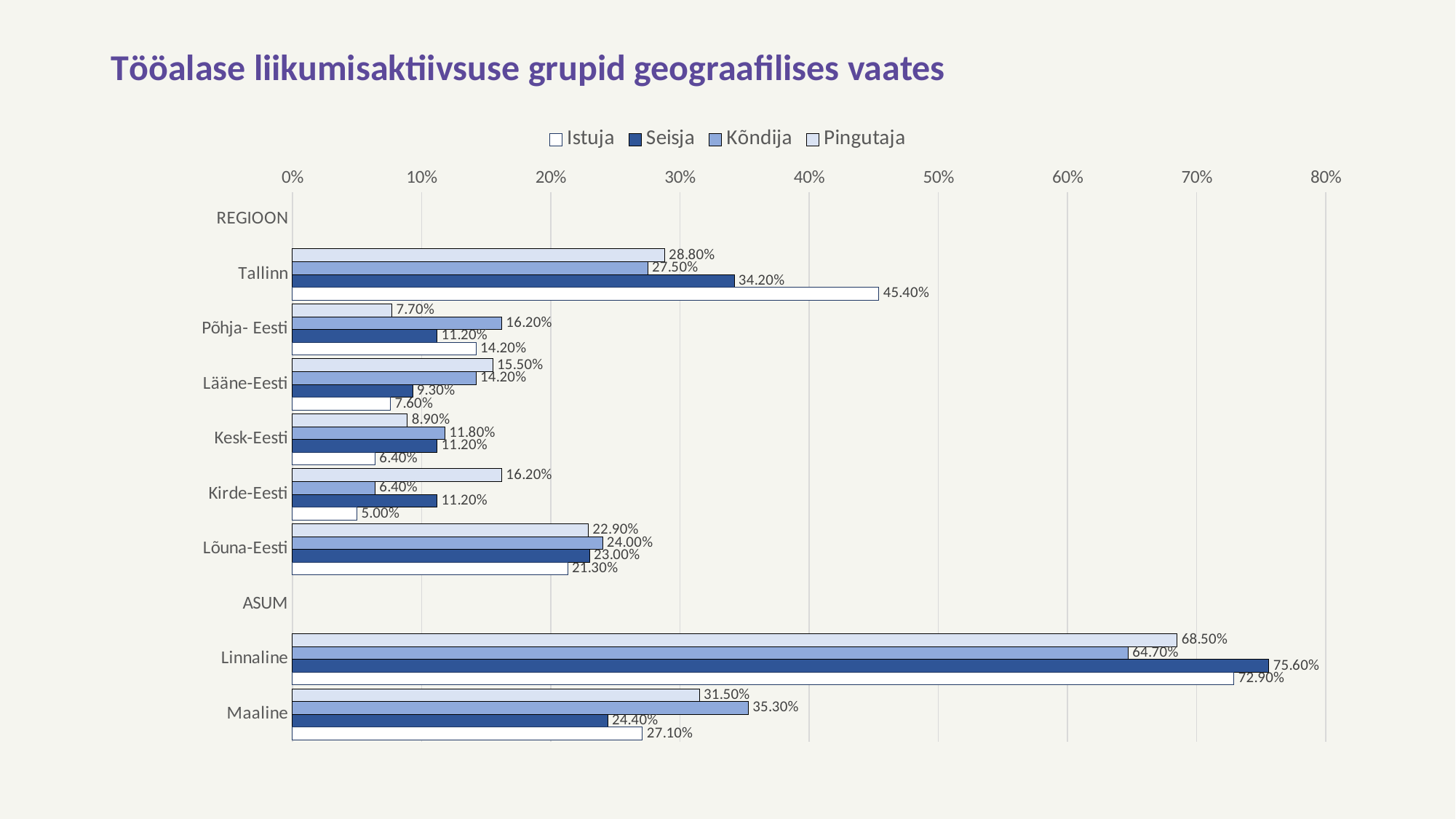
What is the Istuja value for Tallinn? 45.40% What is the difference between the Seisja values for Linnaline and Maaline? 51.20% Which region among Tallinn, Põhja-Eesti, Lääne-Eesti, Kesk-Eesti, Kirde-Eesti and Lõuna-Eesti has the lowest Istuja value? Kirde-Eesti What kind of chart is shown on the slide? Bar chart Is the Pingutaja value for Linnaline greater or less than 60%? greater How many series does the legend list? 4 What is the Kõndija value for Maaline? 35.30% What is the Seisja value for Linnaline? 75.60% Which series is shown with the darkest blue bars? Seisja Which region among Tallinn, Põhja-Eesti, Lääne-Eesti, Kesk-Eesti, Kirde-Eesti and Lõuna-Eesti has the highest Istuja value? Tallinn What is the Pingutaja value for Kirde-Eesti? 16.20% Which is larger for Lõuna-Eesti, the Kõndija value or the Istuja value? Kõndija